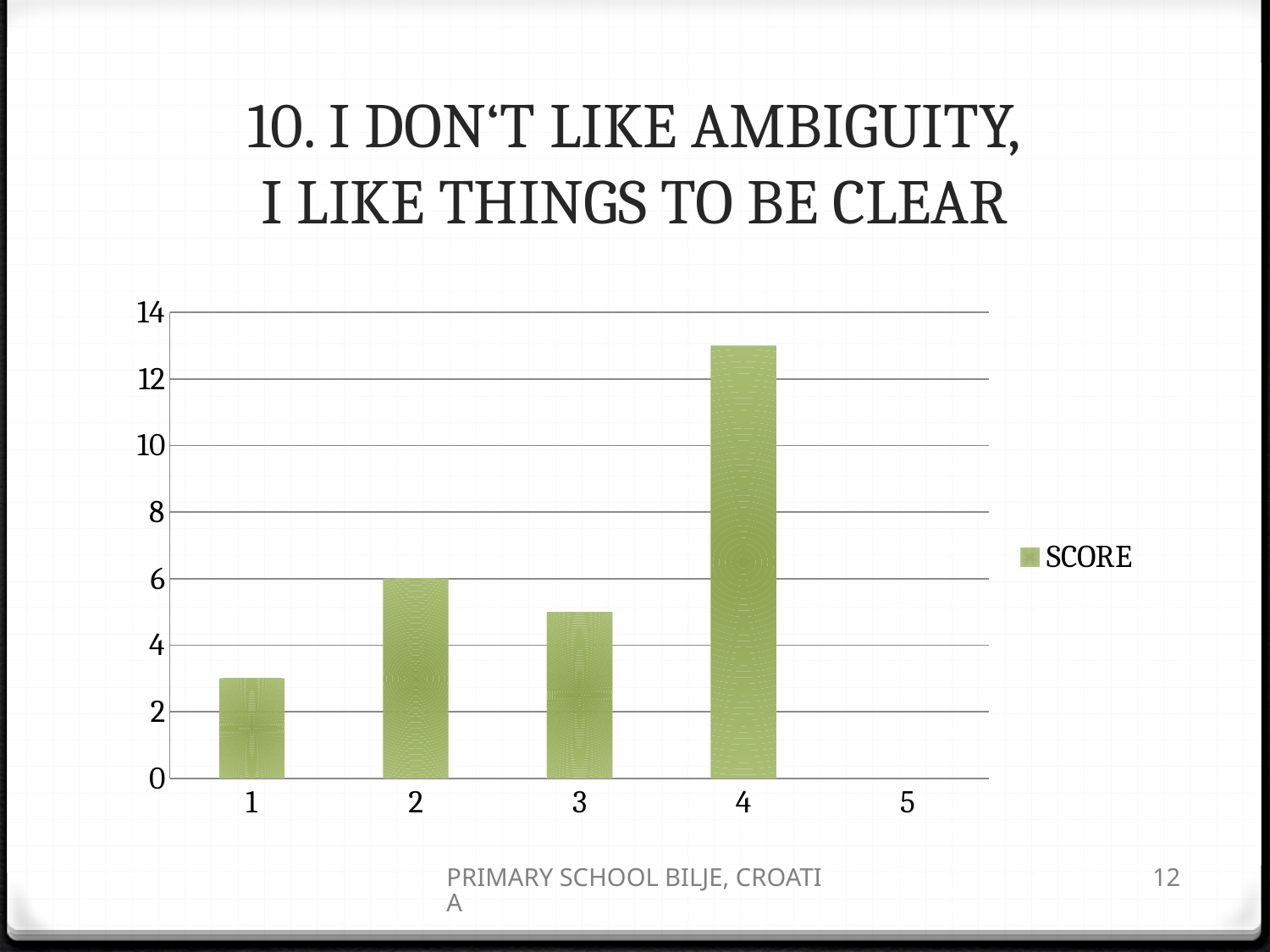
What kind of chart is shown on the slide? bar chart What is the value of SCORE for category 2? 6 Which has a larger SCORE, category 2 or category 3? 2 Is the SCORE for category 1 greater or less than 2? greater How many categories are shown on the x axis? 5 Is the SCORE for category 4 greater or less than 12? greater What is the name of the series shown in the legend? SCORE How many series does the legend list? 1 Which category has the highest SCORE? 4 Which has a larger SCORE, category 1 or category 3? 3 Is the SCORE for category 3 greater or less than 6? less Among categories 1 to 4, which has the lowest SCORE? 1